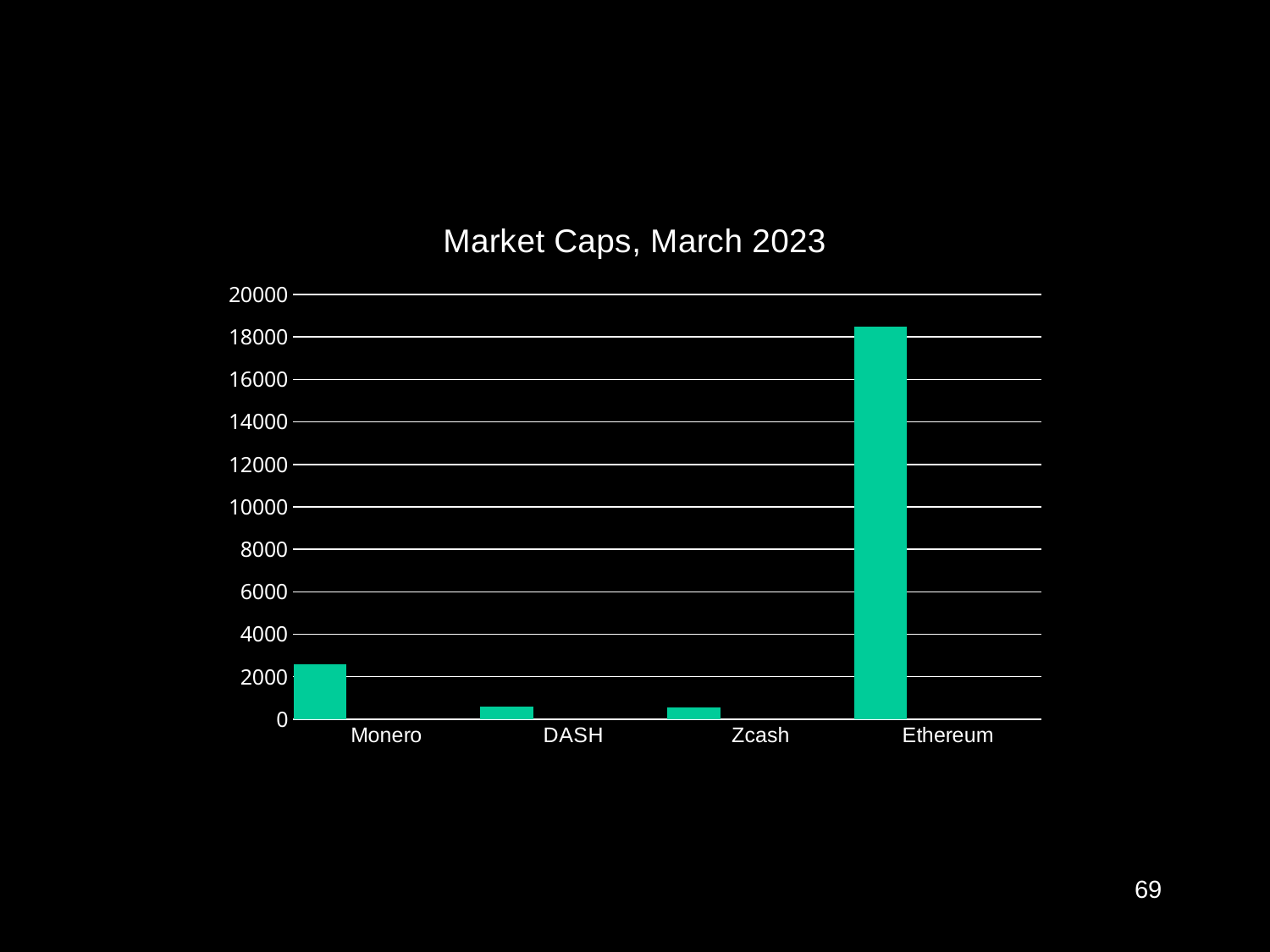
How many categories are plotted in the chart? 4 Which is larger, the value for Zcash or the value for Ethereum? Ethereum Is the value for Zcash greater or less than 2000? less Is the value for Ethereum greater or less than 18000? greater Is the value for DASH greater or less than 2000? less Which category has the highest market cap? Ethereum What is the title of the chart? Market Caps, March 2023 Which is larger, the value for Monero or the value for DASH? Monero What kind of chart is shown on the slide? bar chart